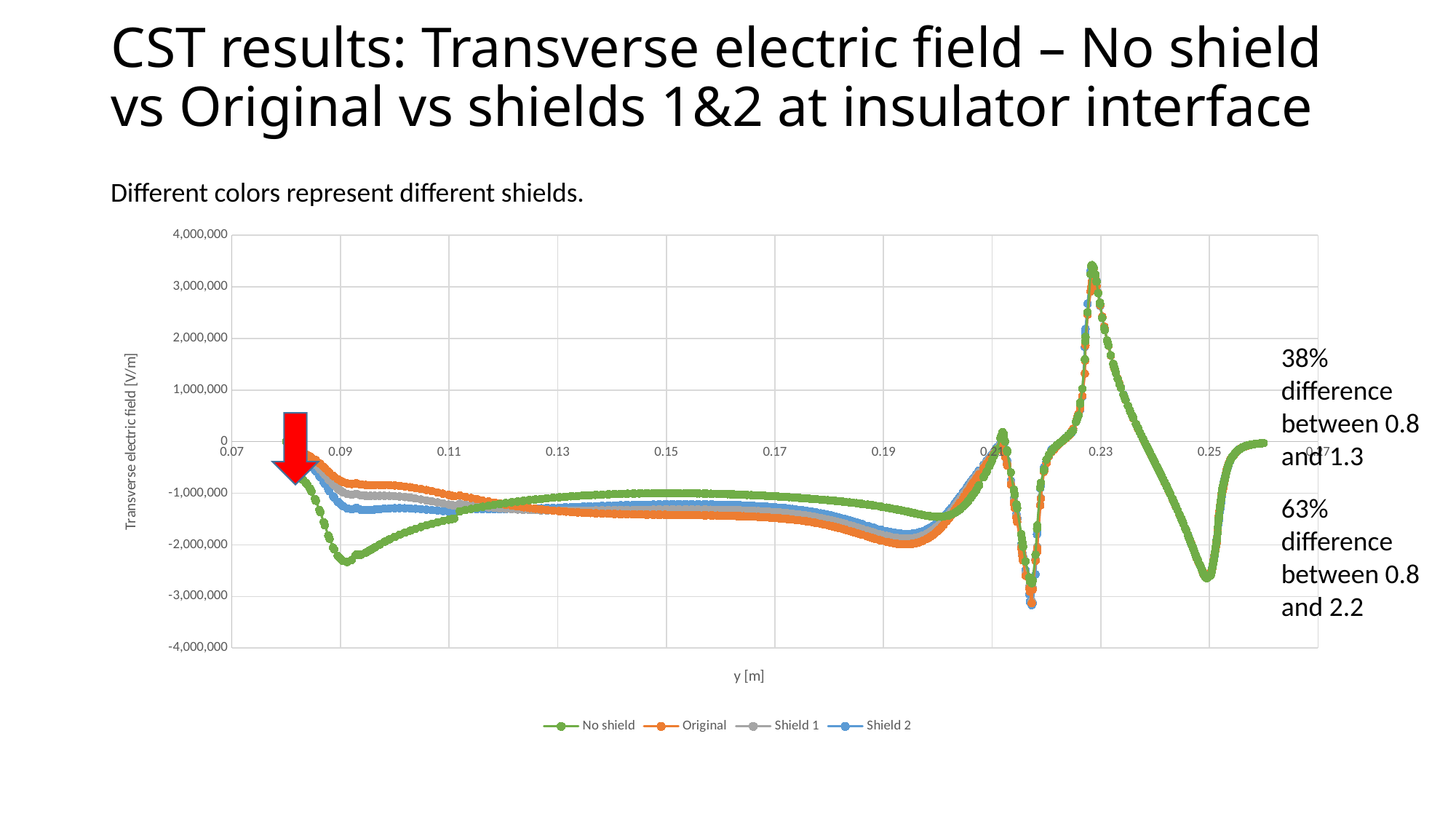
Is the value of the No shield series near y = 0.25 greater or less than -2,000,000? less Is the value of the Original series near y = 0.19 greater or less than -1,000,000? less Do the values rise or fall along the x axis between y = 0.25 and y = 0.27? rise What is the label of the x axis? y [m] Near y = 0.09, which series has the lower value, No shield or Original? No shield What are the series names listed in the legend? No shield, Original, Shield 1, Shield 2 Is the lowest value of the No shield series near y = 0.09 greater or less than -2,000,000? less What kind of chart is shown on the slide? line chart Do the values rise or fall along the x axis between y = 0.23 and y = 0.25? fall How many series does the legend list? 4 Near y = 0.19, which series has the higher value, No shield or Original? No shield